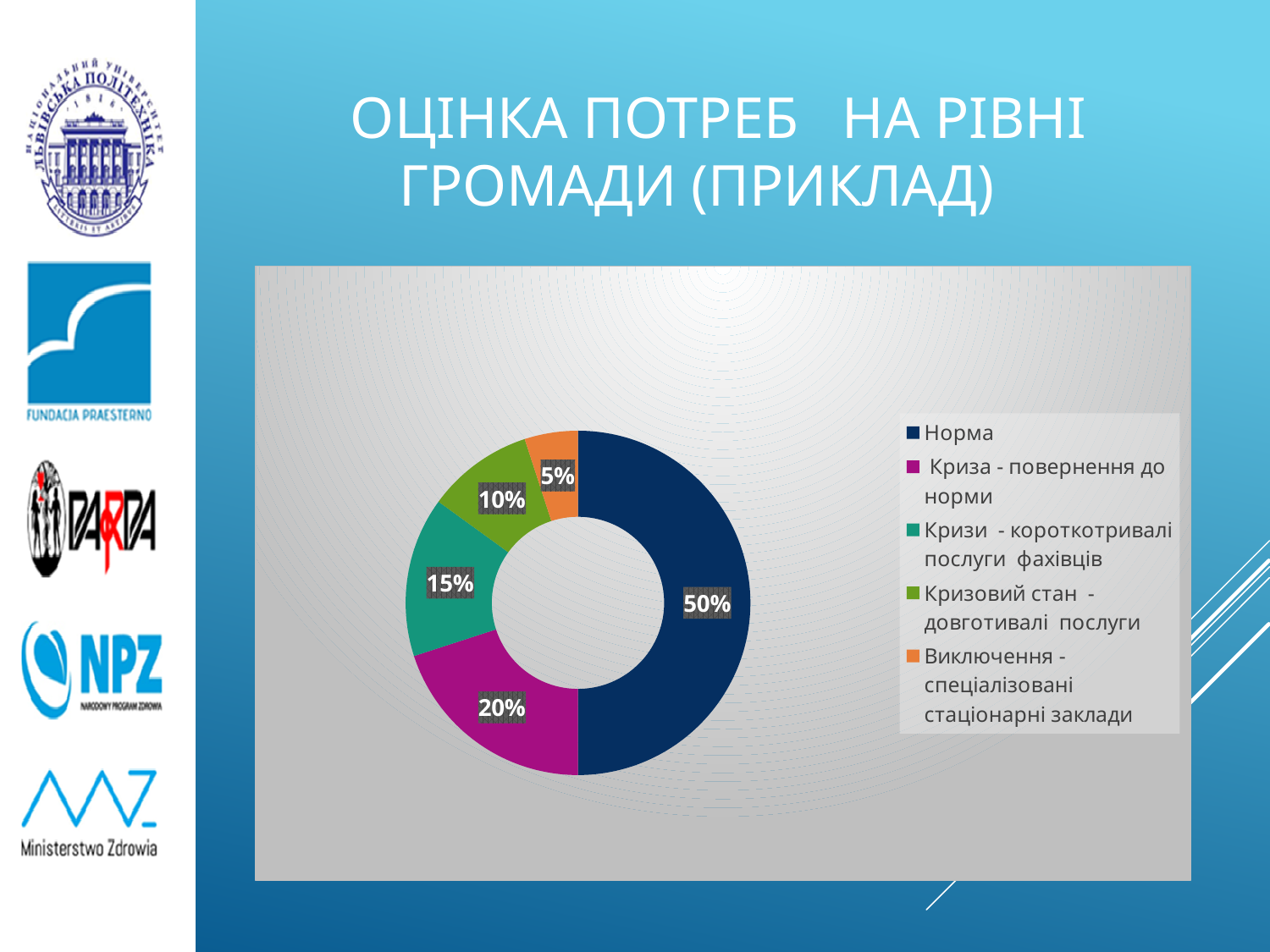
What percentage is shown for the "Кризи - короткотривалі послуги фахівців" slice? 15% How many categories (slices) does the chart contain? 5 What percentage is shown for the "Криза - повернення до норми" slice? 20% Which category has the smallest share of the chart? Виключення - спеціалізовані стаціонарні заклади What percentage is shown for the "Кризовий стан - довготивалі послуги" slice? 10% What is the difference in percentage points between the "Норма" slice and the "Криза - повернення до норми" slice? 30 percentage points What percentage is shown for the "Виключення - спеціалізовані стаціонарні заклади" slice? 5% What percentage is shown for the "Норма" slice? 50% Which is larger: the "Кризи - короткотривалі послуги фахівців" slice or the "Кризовий стан - довготивалі послуги" slice? Кризи - короткотривалі послуги фахівців Which category has the largest share of the chart? Норма What type of chart is shown on the slide? Doughnut (pie) chart What colour is the "Норма" slice in the chart? Dark blue